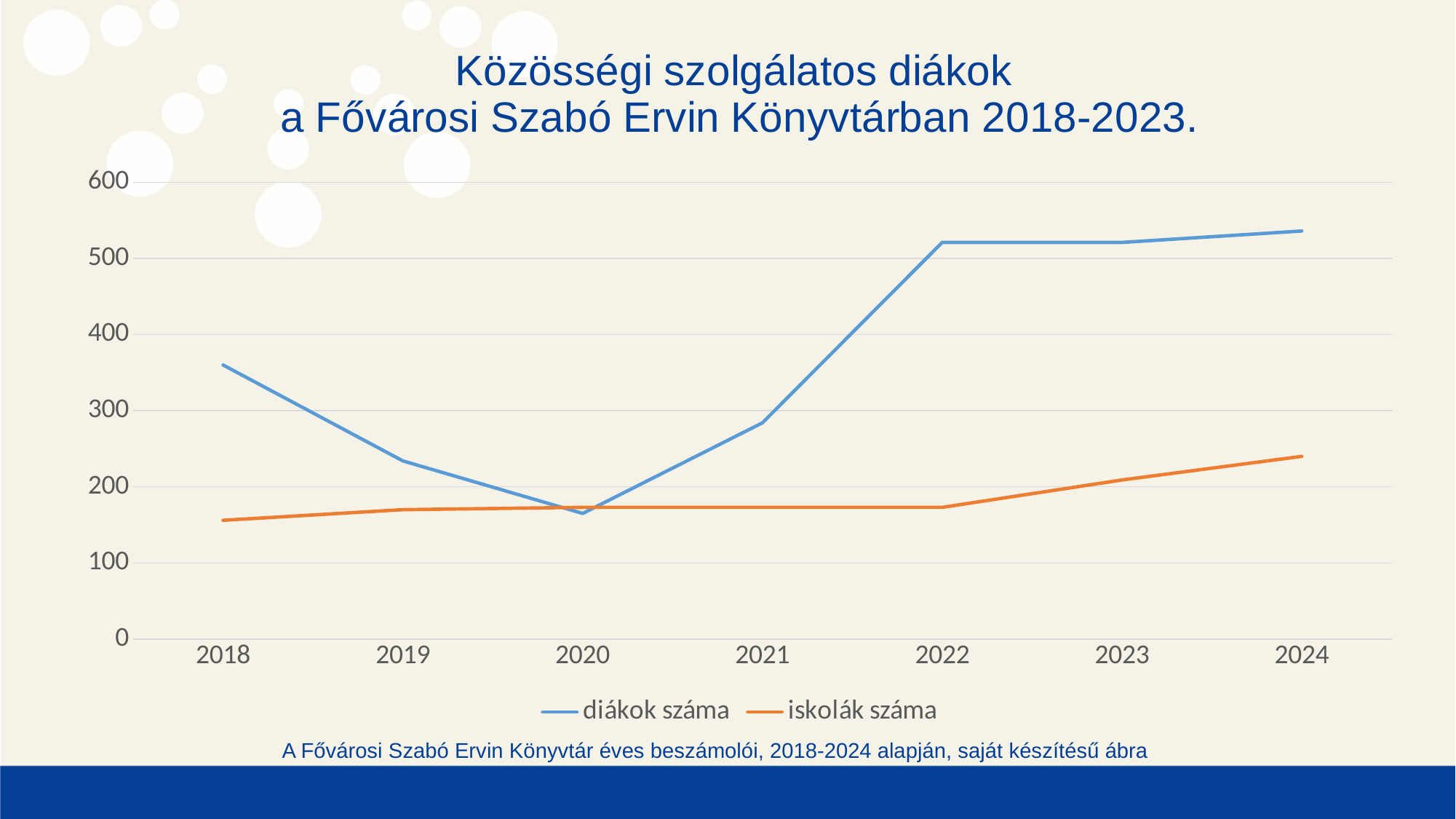
Does the 'iskolák száma' line rise or fall from 2022 to 2024? rise How many years are plotted along the x axis? 7 Which series has the larger value in 2024, 'diákok száma' or 'iskolák száma'? diákok száma Is the value for 'iskolák száma' in 2024 greater or less than 200? greater Is the value for 'diákok száma' in 2018 greater or less than 300? greater In which year is the value for 'iskolák száma' highest? 2024 Is the value for 'diákok száma' in 2020 greater or less than 200? less What kind of chart is shown on the slide? line chart How many series does the legend list? 2 In which year is the value for 'diákok száma' lowest? 2020 In which year is the value for 'iskolák száma' lowest? 2018